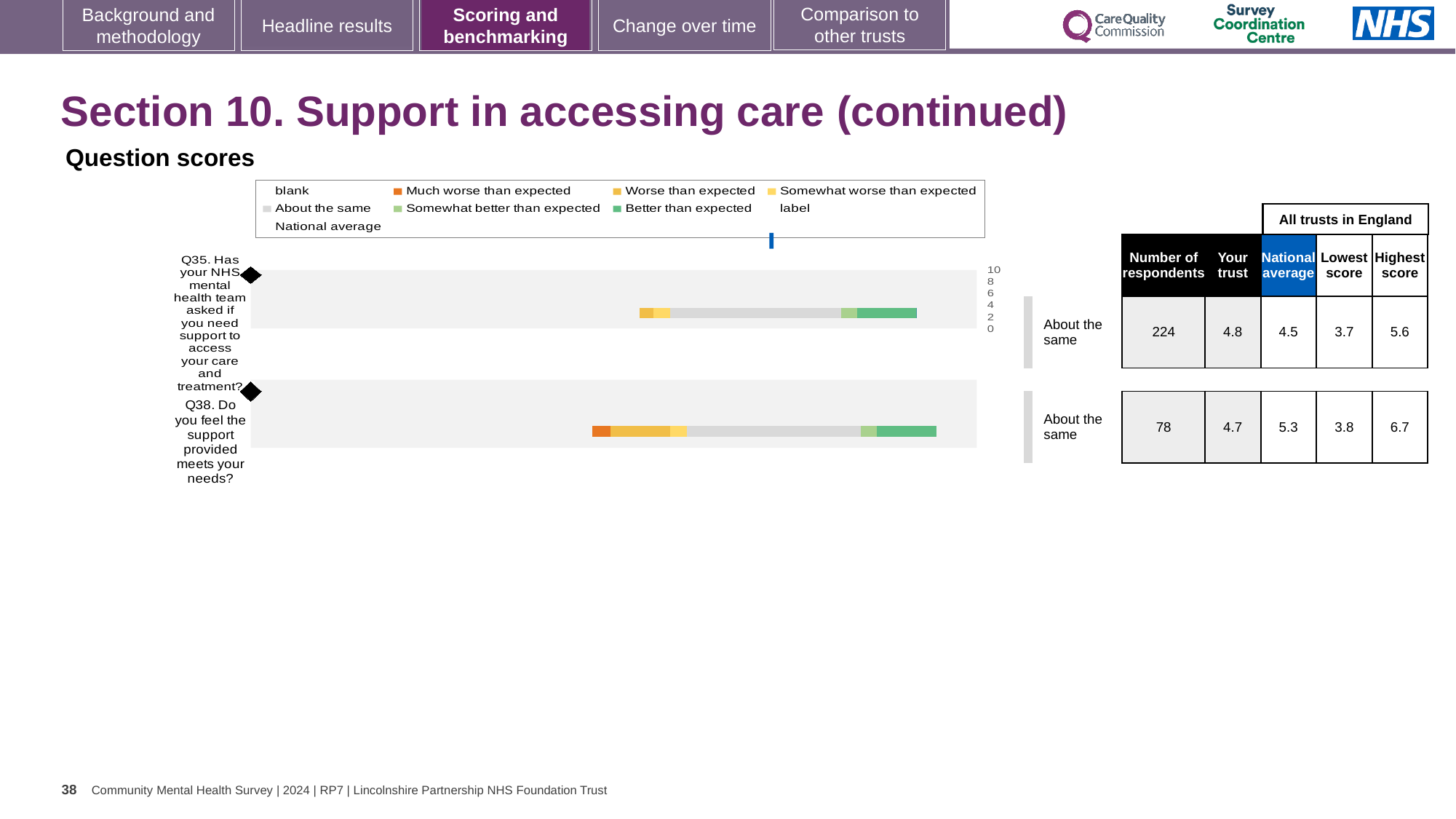
Which question had more respondents, Q35 or Q38? Q35 What is the 'Your trust' score for Q38 (Do you feel the support provided meets your needs?)? 4.7 What is the 'Your trust' score for Q35 (Has your NHS mental health team asked if you need support to access your care and treatment?)? 4.8 What benchmark category is shown next to the bar for Q38? About the same For Q35, which is larger: the trust's score or the national average? Your trust How many questions are plotted in the question scores chart? 2 How many more respondents answered Q35 than Q38? 146 What is the highest score across all trusts in England for Q38? 6.7 What is the national average score for Q38? 5.3 What kind of chart is used to show the question scores on this slide? bar chart How many respondents answered Q35? 224 What is the difference between the highest score and the lowest score for Q38? 2.9